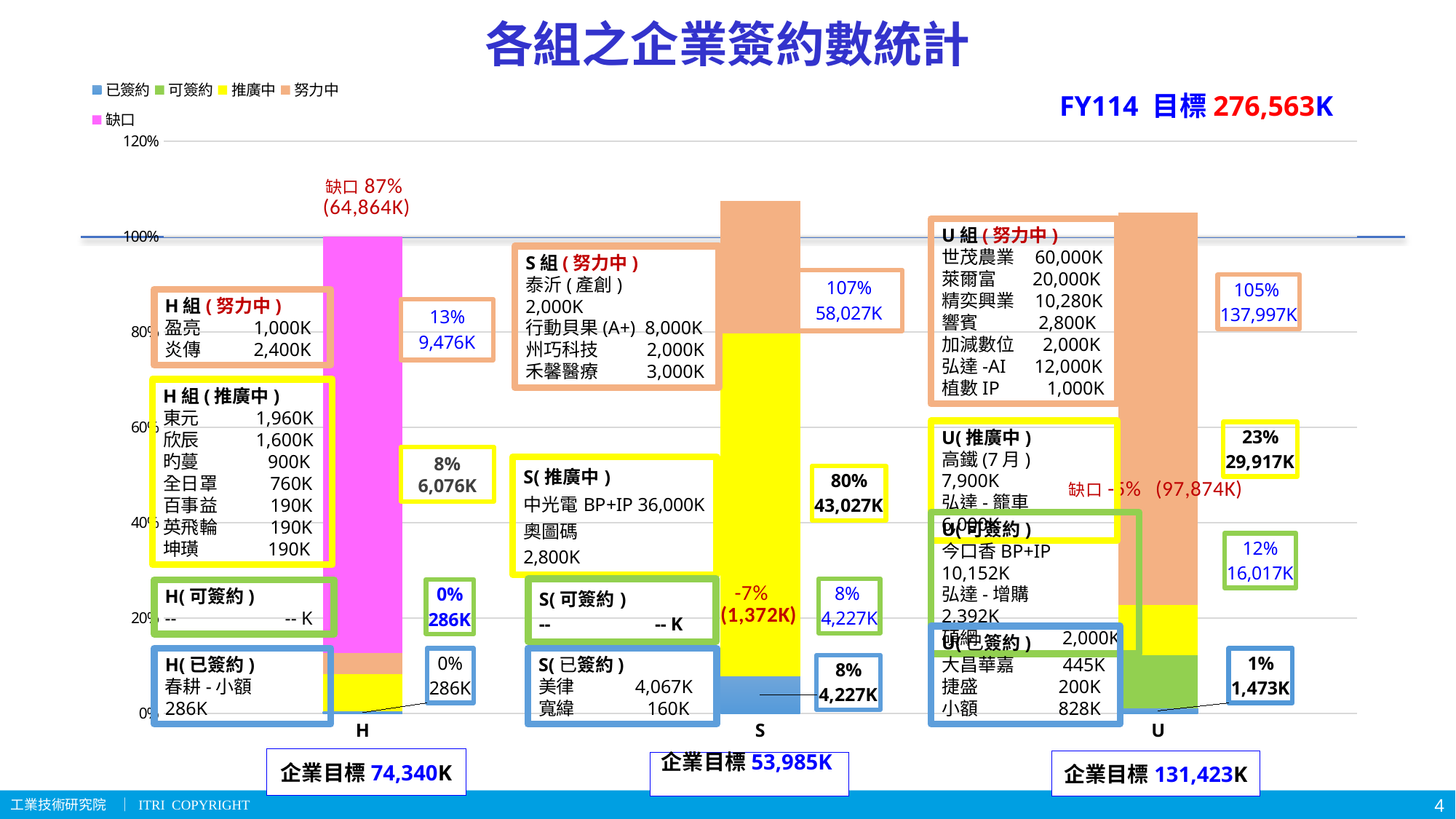
What percentage is labelled for the 已簽約 segment of group S? 8% What percentage is labelled for the 努力中 segment of group S? 107% What is the difference between the 努力中 values of group U (137,997K) and group S (58,027K)? 79,970K What is the FY114 目標 shown at the top right of the slide? 276,563K Which group has the highest 企業目標? U What percentage is labelled for the 缺口 segment of group H? 87% What kind of chart is shown on the slide? stacked bar chart What is the 推廣中 value labelled for group H? 6,076K What is the 可簽約 value labelled for group U? 16,017K How many groups (categories) are plotted along the x axis? 3 How many series does the legend list? 5 Which group has the larger 推廣中 value, S or U? S